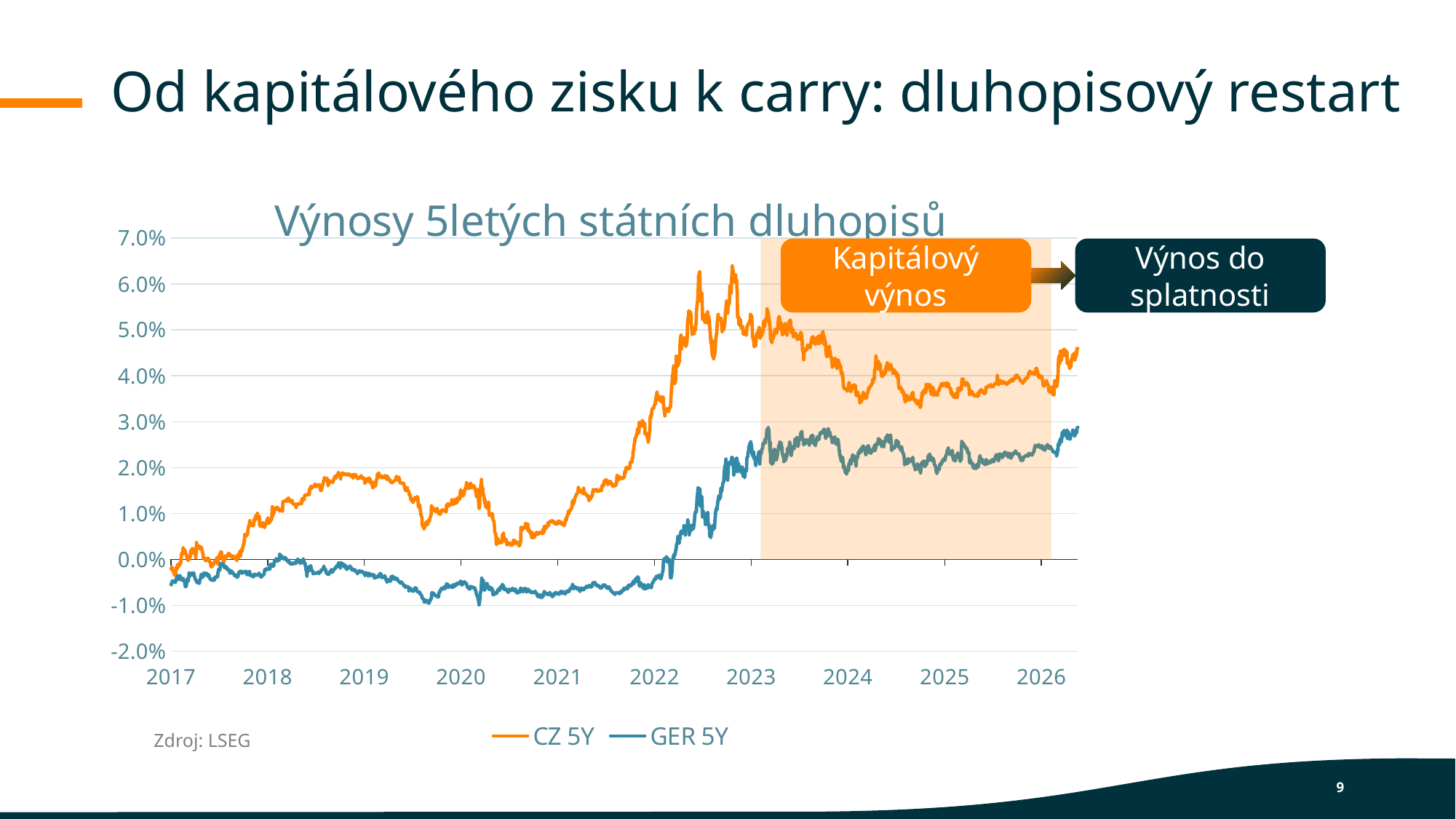
Is the value of the CZ 5Y series at the start of 2019 greater or less than 1.0%? greater How many series does the legend of the chart list? 2 What kind of chart is shown on the slide? line chart What is the title of the chart? Výnosy 5letých státních dluhopisů Does the GER 5Y series rise or fall between the start of 2021 and the start of 2023? rise Is the value of the GER 5Y series at the start of 2023 greater or less than 1.0%? greater Which series has the higher value during 2018, CZ 5Y or GER 5Y? CZ 5Y What are the two series named in the chart legend? CZ 5Y and GER 5Y Is the peak value of the CZ 5Y series in 2022 greater or less than 5.0%? greater Which series has the higher value at the start of 2026, CZ 5Y or GER 5Y? CZ 5Y